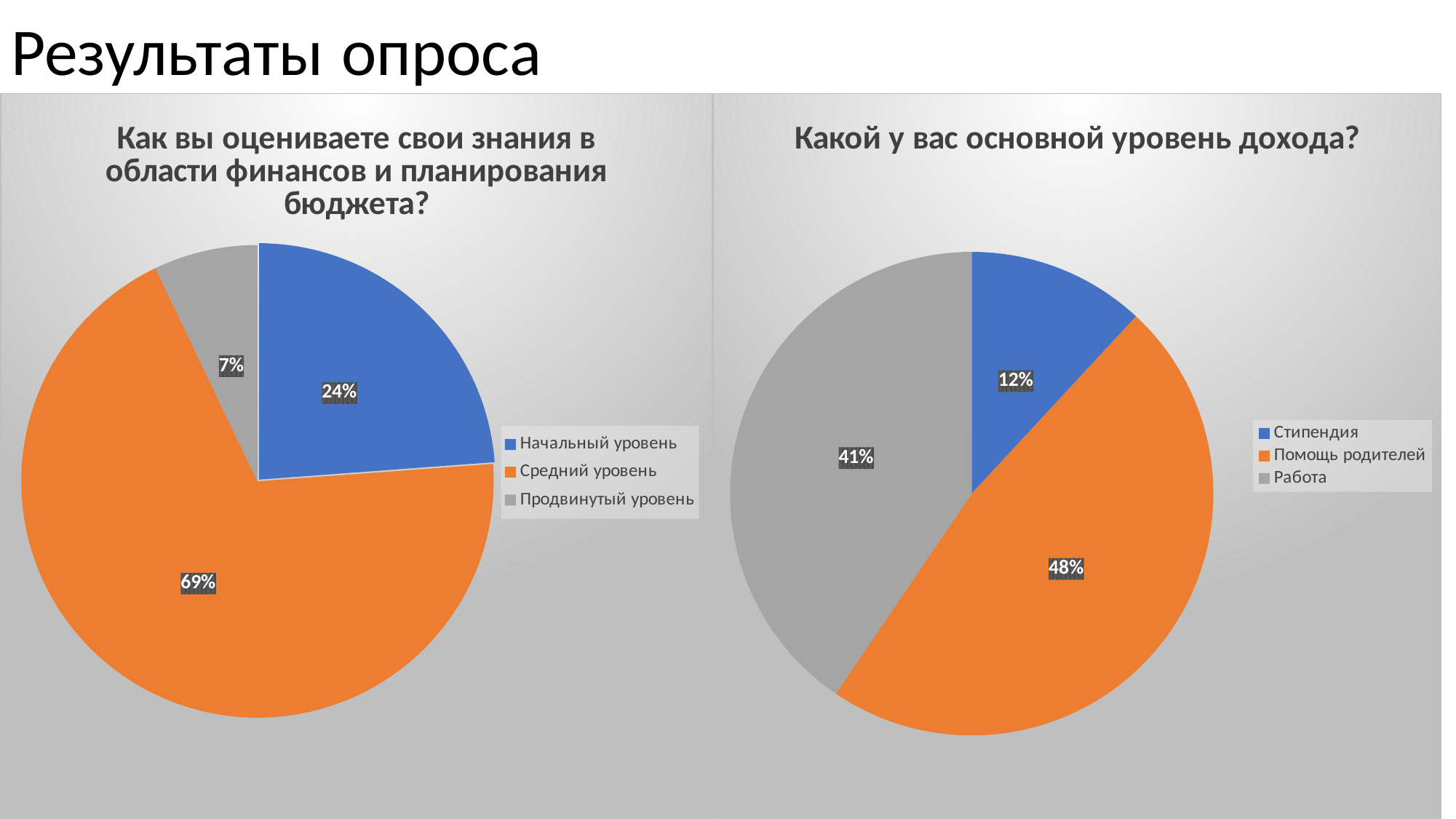
In the right chart (Какой у вас основной уровень дохода?), what colour is the Работа slice? Grey In the left chart (Как вы оцениваете свои знания в области финансов и планирования бюджета?), what share is labelled for Средний уровень? 69% In the left chart (Как вы оцениваете свои знания в области финансов и планирования бюджета?), which category has the smallest slice? Продвинутый уровень In the left chart (Как вы оцениваете свои знания в области финансов и планирования бюджета?), what share is labelled for Начальный уровень? 24% In the right chart (Какой у вас основной уровень дохода?), what is the difference between the Работа and Стипендия shares? 29% What type of chart is the right chart (Какой у вас основной уровень дохода?)? Pie chart In the right chart (Какой у вас основной уровень дохода?), what share is labelled for Стипендия? 12% In the right chart (Какой у вас основной уровень дохода?), which category has the largest slice? Помощь родителей In the left chart (Как вы оцениваете свои знания в области финансов и планирования бюджета?), what is the difference between the Средний уровень and Начальный уровень shares? 45% In the left chart (Как вы оцениваете свои знания в области финансов и планирования бюджета?), how many categories does the legend list? 3 In the right chart (Какой у вас основной уровень дохода?), what share is labelled for Работа? 41% In the right chart (Какой у вас основной уровень дохода?), which is larger: Помощь родителей or Работа? Помощь родителей